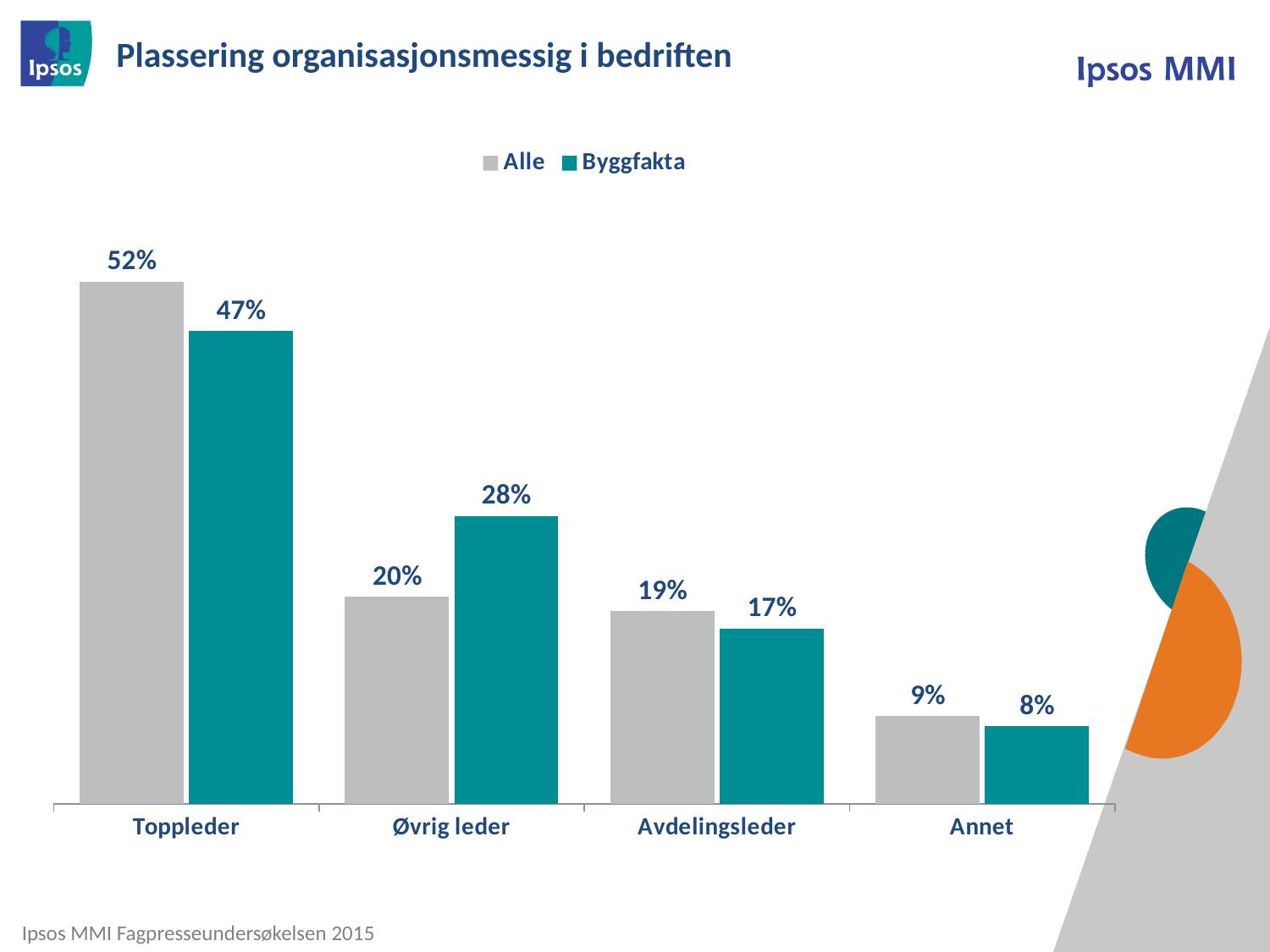
What is the value for Byggfakta in the Øvrig leder category? 28% What is the value for Byggfakta in the Annet category? 8% How many series does the legend list? 2 What is the value for Alle in the Toppleder category? 52% Which category has the lowest value for Byggfakta? Annet What is the title of the chart? Plassering organisasjonsmessig i bedriften What is the difference between Byggfakta and Alle in the Øvrig leder category? 8% What kind of chart is shown on the slide? Bar chart What is the difference between Alle and Byggfakta in the Toppleder category? 5% Which category has the highest value for Alle? Toppleder Which is larger in the Avdelingsleder category, Alle or Byggfakta? Alle How many categories are shown on the x axis? 4